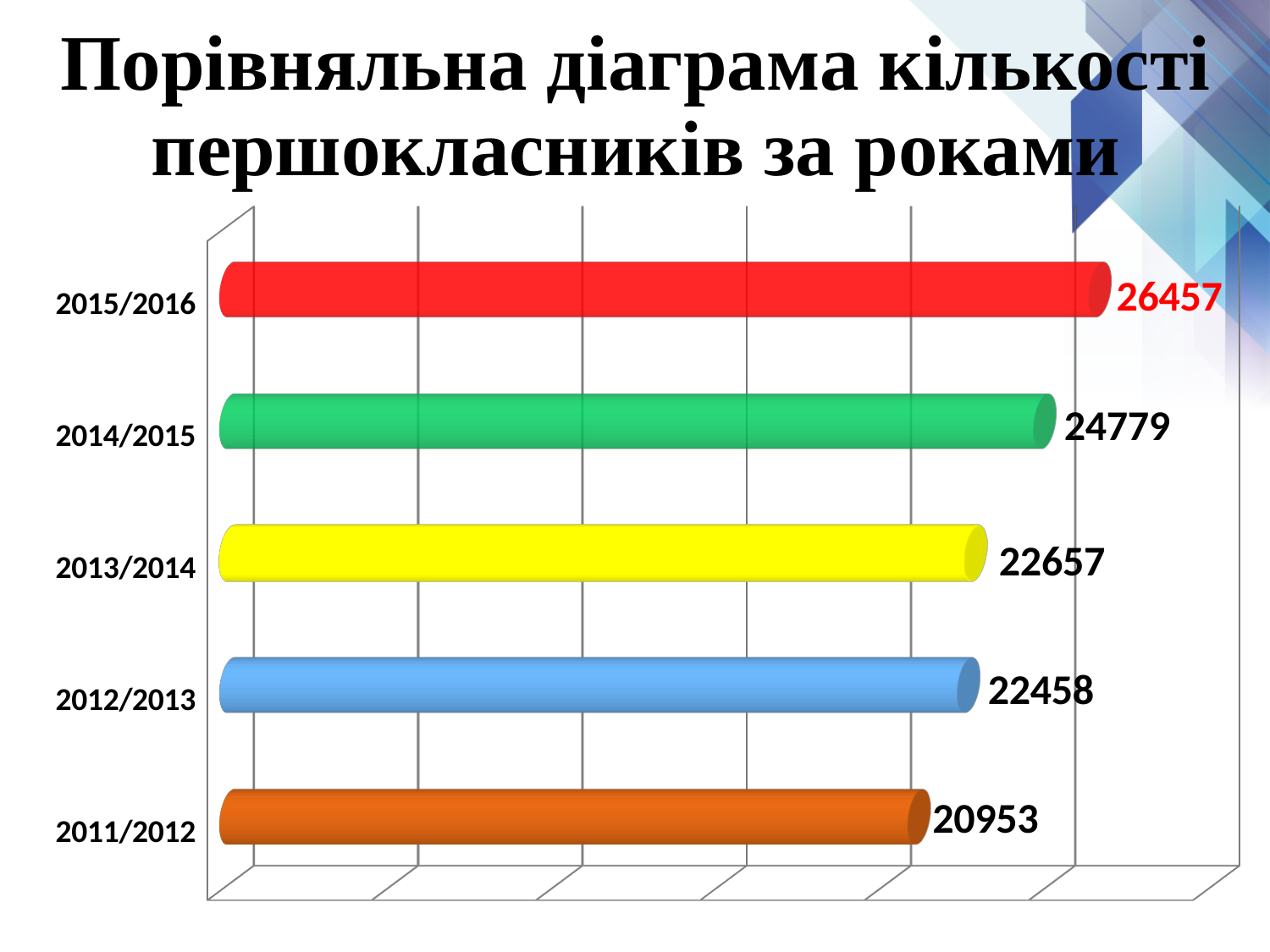
Do the values rise or fall from 2011/2012 to 2015/2016? rise Which year has the lowest value? 2011/2012 Which year has the highest value? 2015/2016 What kind of chart is shown on the slide? bar chart What is the value for 2013/2014? 22657 What is the value for 2011/2012? 20953 What is the value for 2012/2013? 22458 What is the difference between the values for 2015/2016 and 2014/2015? 1678 How many years are shown in the chart? 5 What is the value for 2015/2016? 26457 Which is larger, the value for 2014/2015 or the value for 2013/2014? 2014/2015 What is the difference between the values for 2013/2014 and 2012/2013? 199